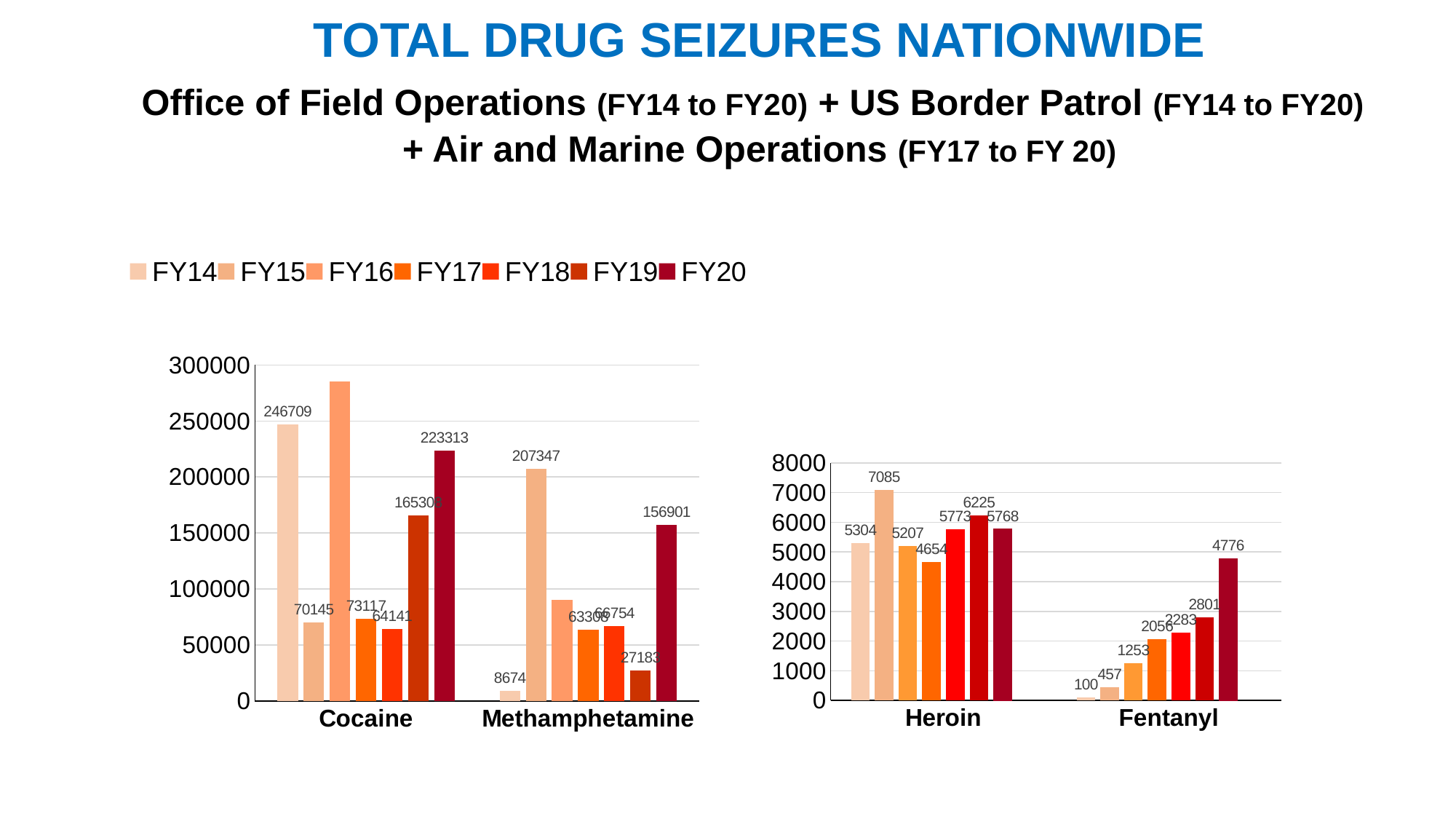
On the left chart, which fiscal year has the lowest value for Methamphetamine? FY14 On the left chart, which is larger for Cocaine: the FY20 value or the FY14 value? FY14 On the right chart, what is the difference between the Fentanyl values for FY20 and FY19? 1975 On the left chart, is the FY16 value for Cocaine greater or less than 250000? greater On the right chart, what is the value for Fentanyl in FY20? 4776 On the right chart, do the Fentanyl values rise or fall from FY14 to FY20? rise On the right chart, what is the value for Heroin in FY15? 7085 How many series does the legend list? 7 On the left chart, what is the value for Methamphetamine in FY20? 156901 On the left chart, what is the value for Cocaine in FY14? 246709 On the right chart, which fiscal year has the highest value for Fentanyl? FY20 What kind of chart is the right chart? bar chart